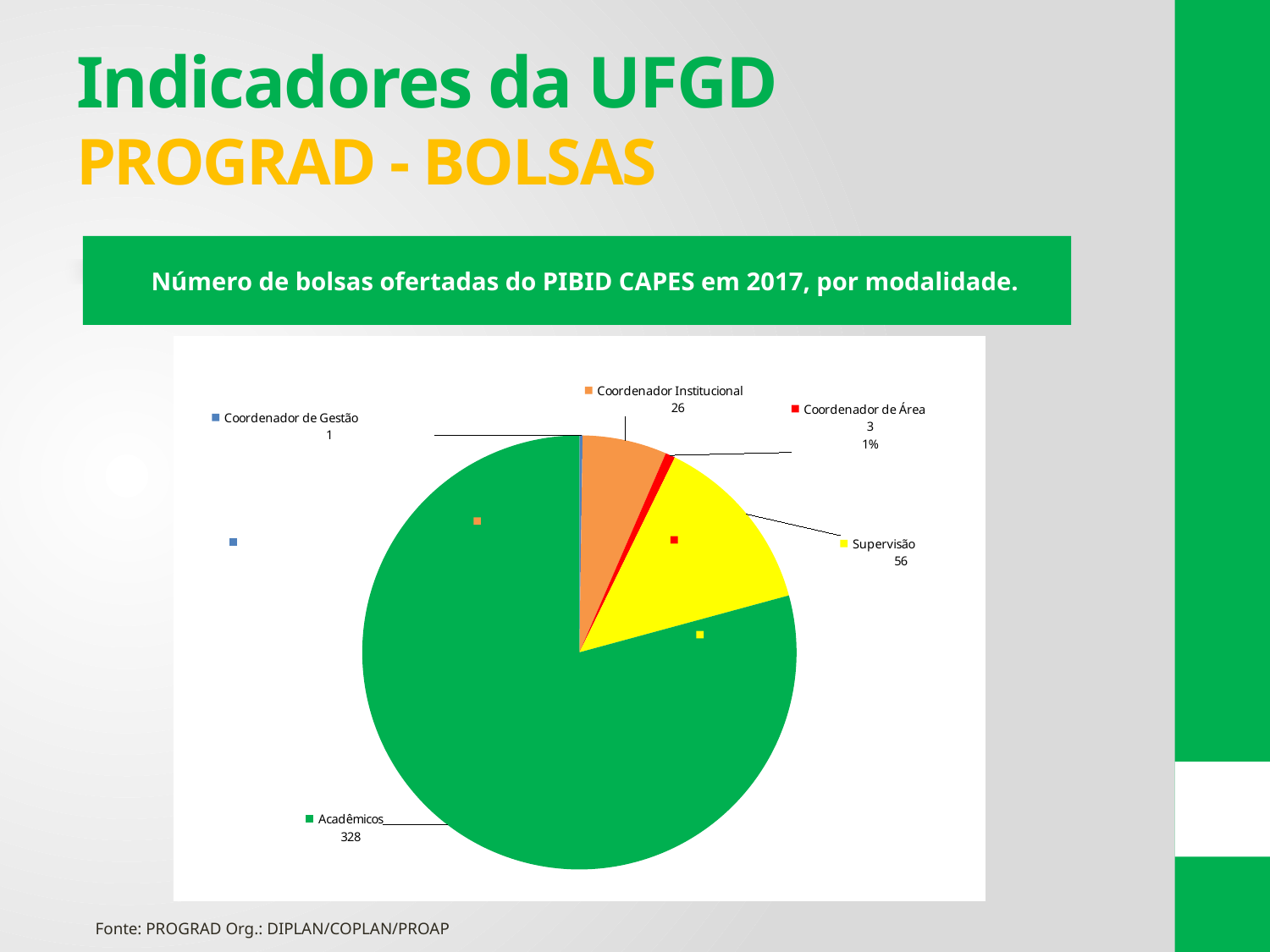
What is the value for Supervisão? 56 What is the value for Coordenador de Área? 3 Which is larger, the value for Supervisão or the value for Coordenador de Área? Supervisão What percentage share of the pie is shown for Coordenador de Área? 1% What is the value for Coordenador de Gestão? 1 Which category has the largest slice of the pie? Acadêmicos Which category has the smallest slice of the pie? Coordenador de Gestão What is the difference between the values for Supervisão and Coordenador Institucional? 30 How many bolsas are shown for Acadêmicos? 328 How many slices (categories) does the pie chart have? 5 What is the value for Coordenador Institucional? 26 What kind of chart is shown on the slide? pie chart